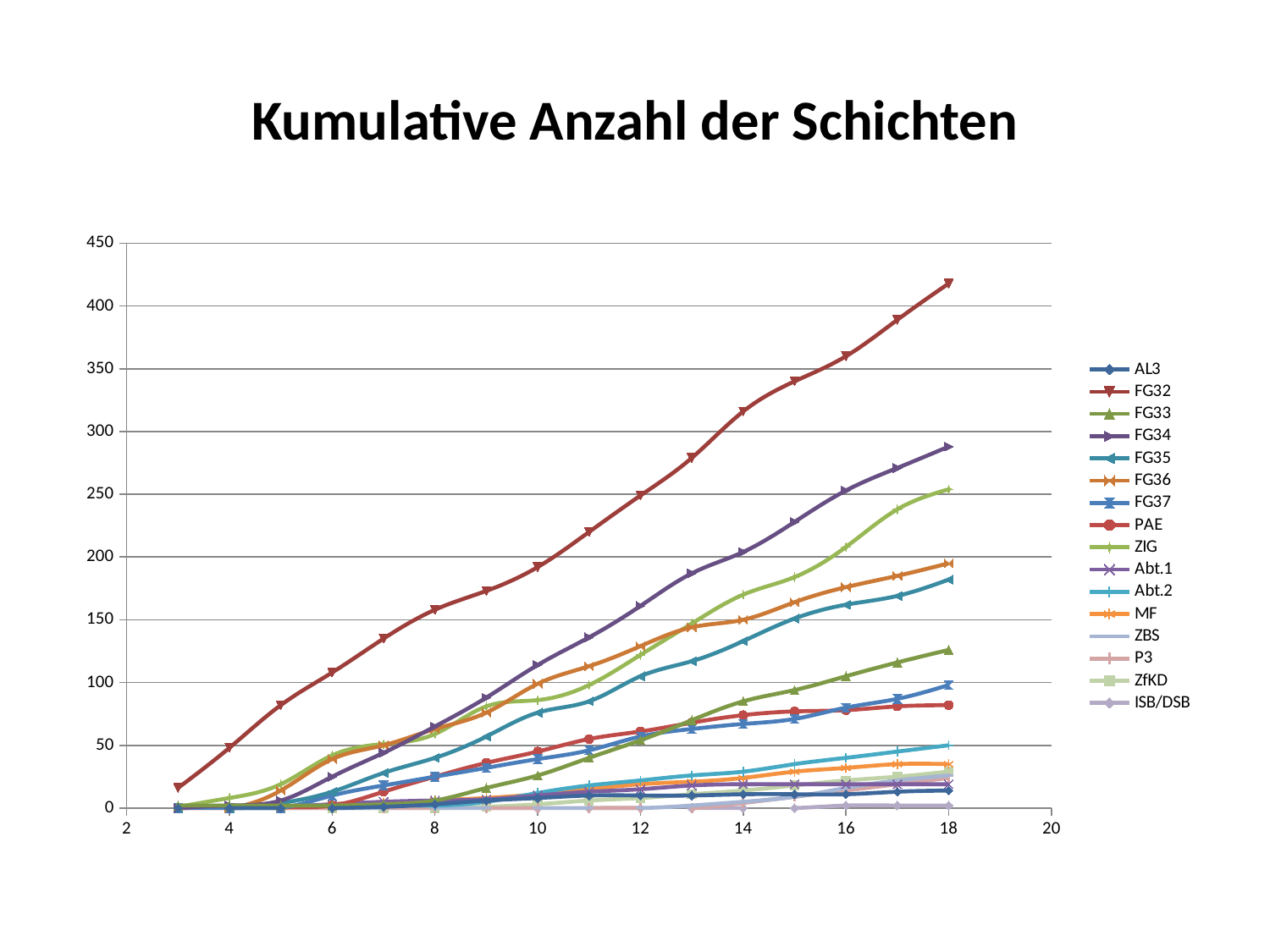
Which series reaches the highest value at x = 18? FG32 What is the title of the chart? Kumulative Anzahl der Schichten Is the value for FG34 at x = 18 greater or less than 300? less Is the value for FG32 at x = 10 greater or less than 150? greater What kind of chart is shown on the slide? line chart How many series does the legend list? 16 Is the value for FG32 at x = 18 greater or less than 400? greater Which series has the larger value at x = 18, FG34 or FG33? FG34 Do the values for FG32 rise or fall as x increases? rise